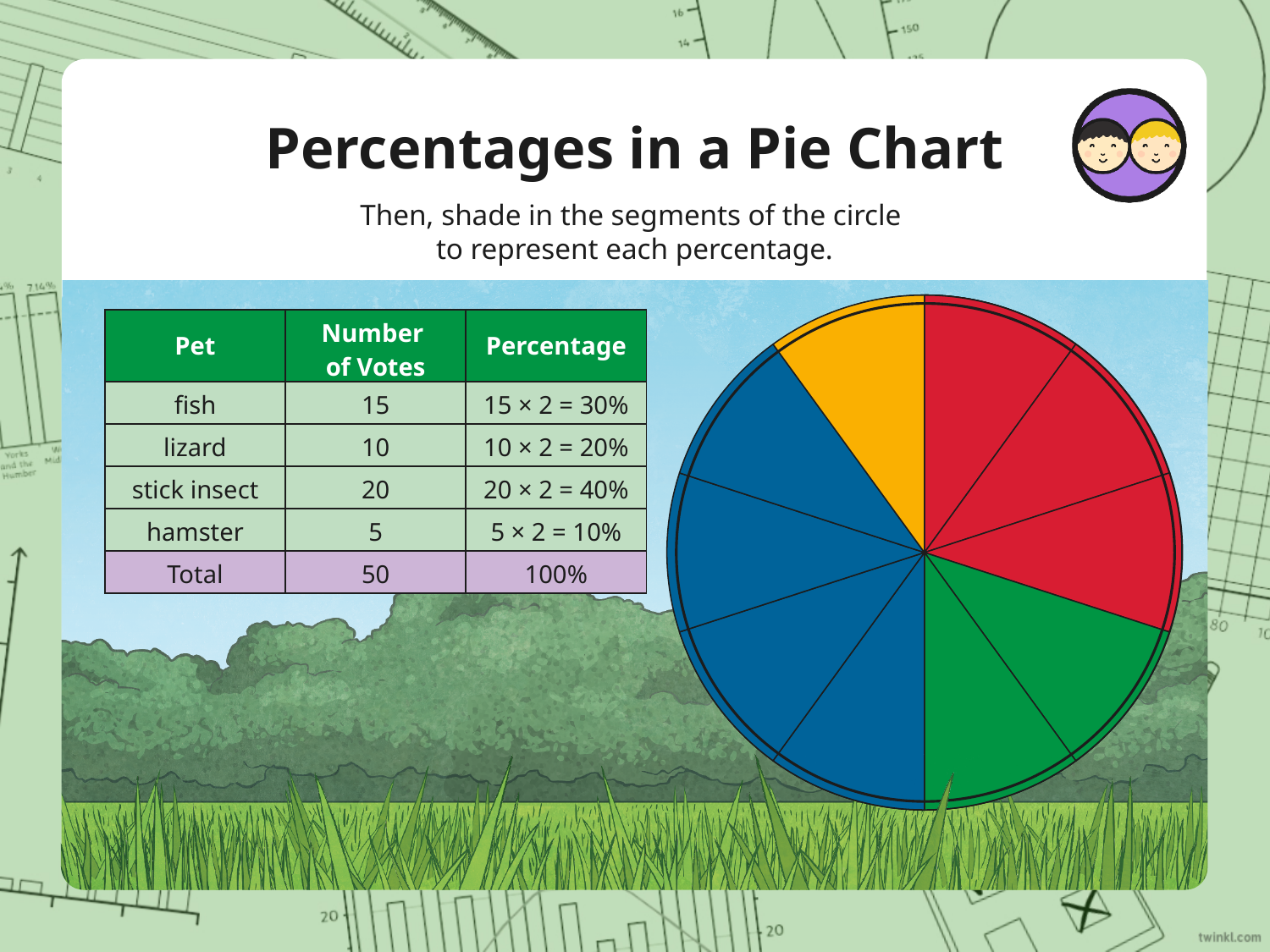
How many votes did hamster receive? 5 What is the total number of votes? 50 What percentage of the votes does stick insect receive according to the table? 40% Which pet received the lowest percentage of votes? hamster Which received more votes, fish or lizard? fish Which colour fills the largest share of the pie chart? blue What is the difference in percentage between stick insect and lizard? 20% How many pet categories are listed in the table? 4 What percentage of the votes does fish receive according to the table? 30% What kind of chart is shown on the right of the slide? pie chart Which pet received the highest percentage of votes? stick insect How many equal segments is the pie chart divided into? 10